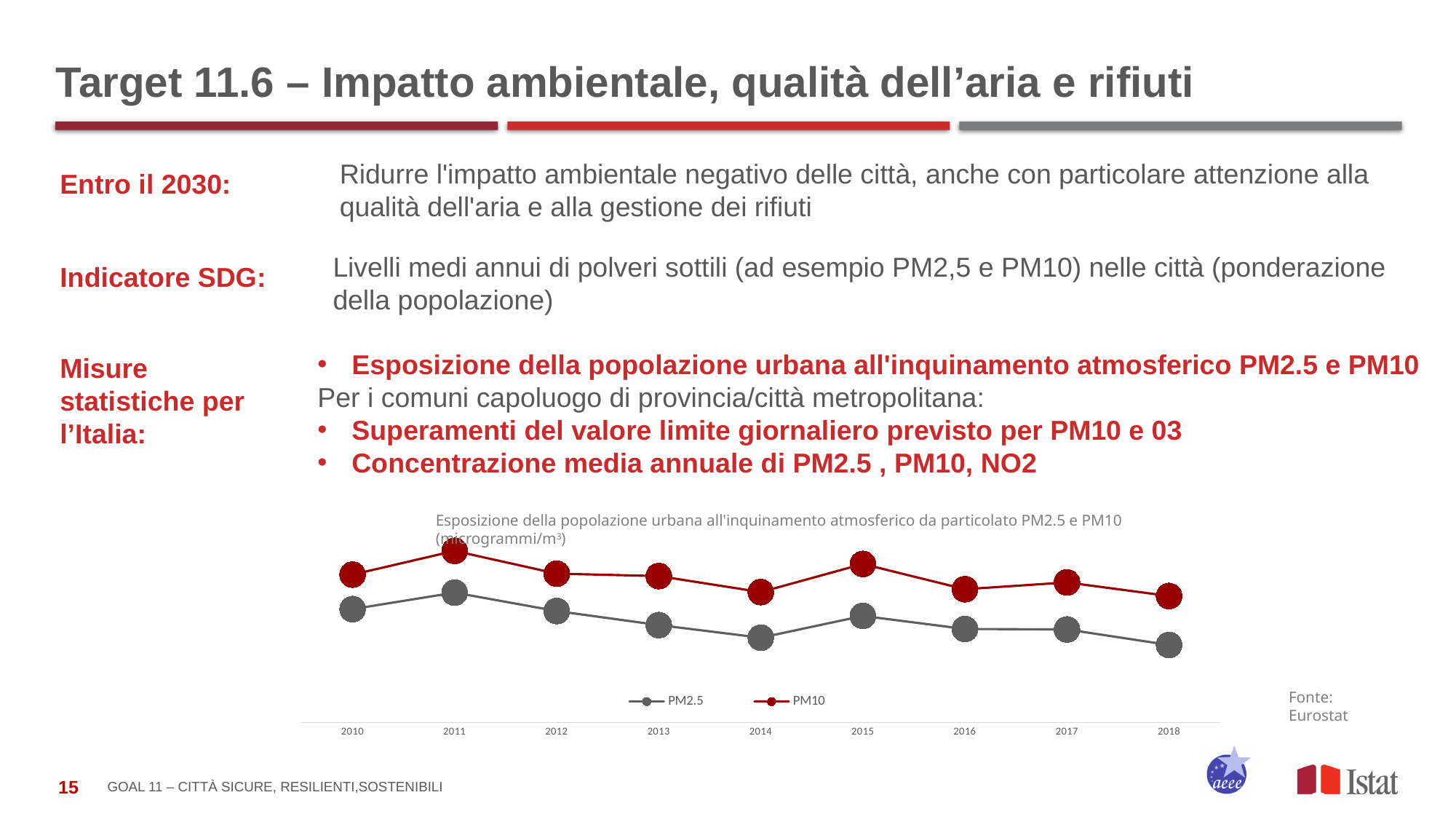
Overall, does the PM2.5 series rise or fall from 2010 to 2018? Fall In which year is the PM2.5 series at its lowest? 2018 For the PM2.5 series, is the value in 2011 higher or lower than in 2014? Higher In which year is the PM10 series at its highest? 2011 For the PM10 series, is the value in 2015 higher or lower than in 2016? Higher In which year is the PM2.5 series at its highest? 2011 In 2015, which series has the higher value, PM2.5 or PM10? PM10 How many series does the chart legend list? 2 What kind of chart is shown on the slide? Line chart Which series are listed in the chart legend? PM2.5 and PM10 How many years are shown on the x axis of the chart? 9 What is the first year shown on the x axis of the chart? 2010